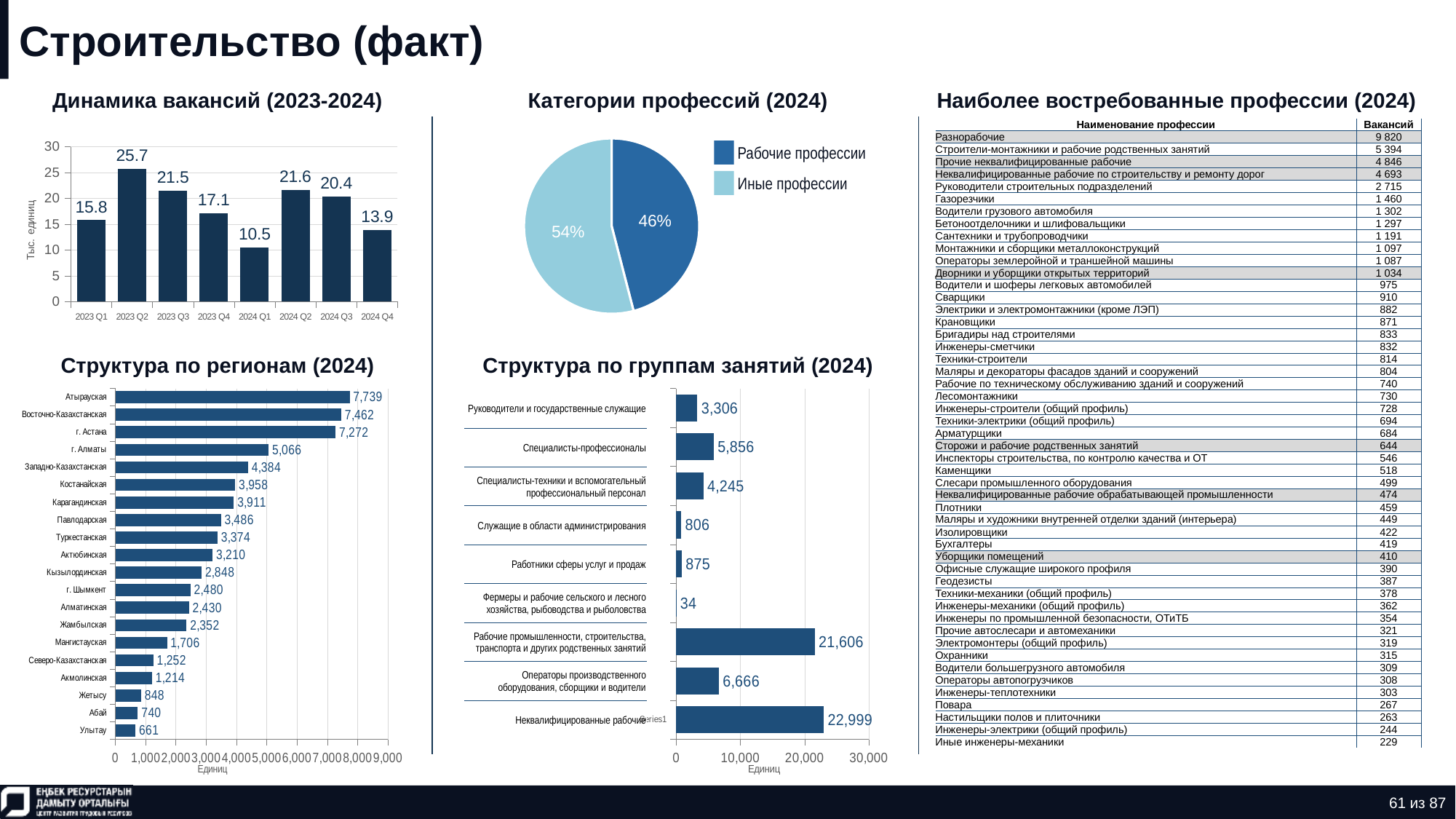
In the chart 'Динамика вакансий (2023-2024)', which quarter has the lowest value? 2024 Q1 In the chart 'Динамика вакансий (2023-2024)', what is the difference between 2024 Q2 and 2024 Q4? 7.7 In the chart 'Структура по группам занятий (2024)', what is the difference between 'Неквалифицированные рабочие' and 'Рабочие промышленности, строительства, транспорта и других родственных занятий'? 1,393 What type of chart is 'Категории профессий (2024)'? Pie chart In the chart 'Динамика вакансий (2023-2024)', how many quarters are plotted? 8 In the chart 'Структура по группам занятий (2024)', which group has the lowest value? Фермеры и рабочие сельского и лесного хозяйства, рыбоводства и рыболовства In the chart 'Структура по группам занятий (2024)', what is the value for 'Операторы производственного оборудования, сборщики и водители'? 6,666 In the chart 'Структура по регионам (2024)', what is the value for г. Астана? 7,272 In the chart 'Категории профессий (2024)', what share does 'Иные профессии' have? 54% In the chart 'Структура по регионам (2024)', which is larger: Костанайская or Карагандинская? Костанайская In the chart 'Динамика вакансий (2023-2024)', what is the value for 2023 Q2? 25.7 In the chart 'Структура по регионам (2024)', which region has the highest value? Атырауская